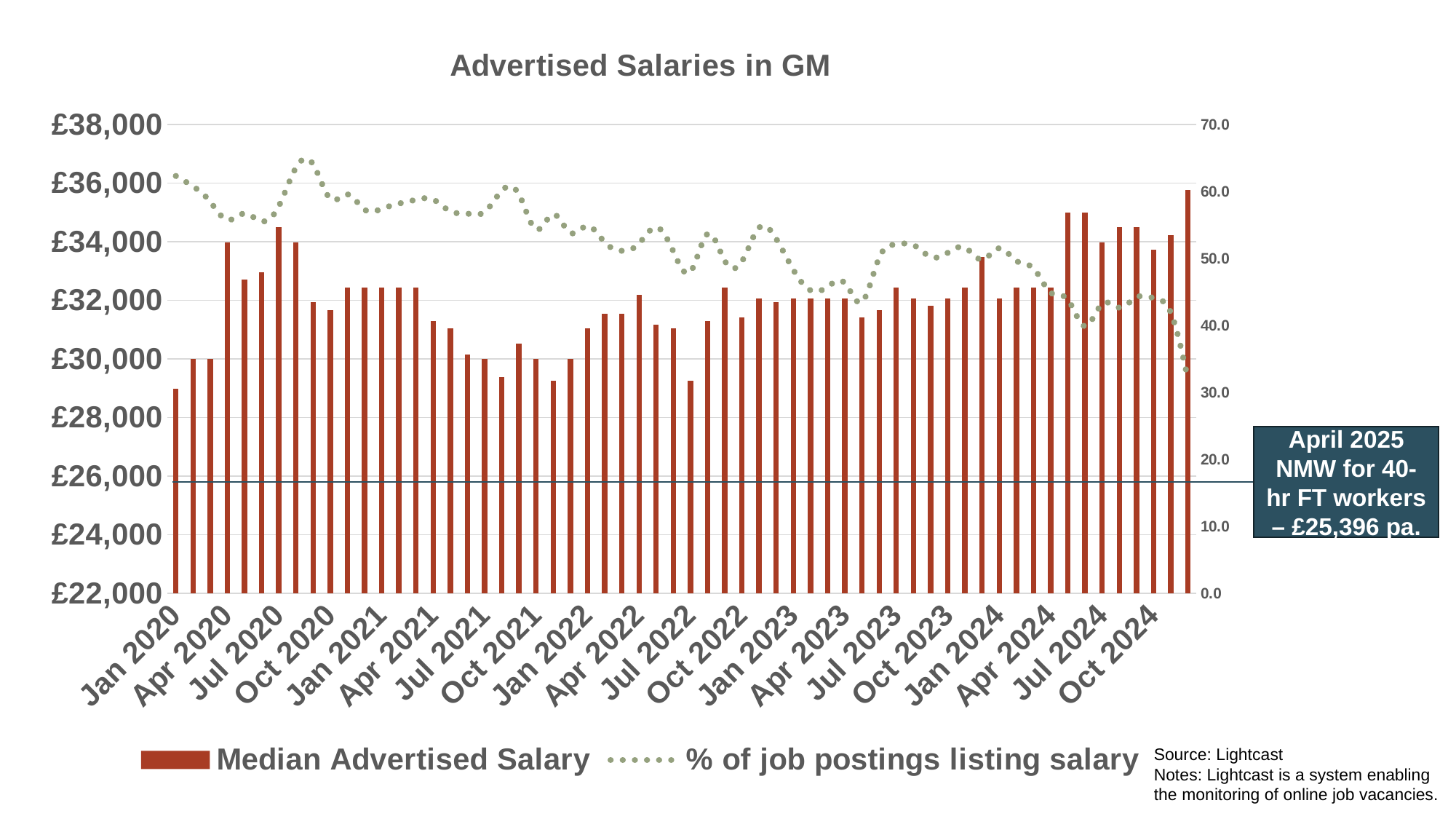
Is the Median Advertised Salary for Jan 2020 greater or less than £30,000? less How many series does the legend list? 2 Which month has the highest Median Advertised Salary bar? Dec 2024 Is the Median Advertised Salary for Jul 2020 greater or less than £32,000? greater Is the % of job postings listing salary for Jan 2020 greater or less than 50.0? greater Does the % of job postings listing salary line generally rise or fall from Jan 2020 to the end of 2024? fall What is the title of the chart? Advertised Salaries in GM How many quarterly date labels are shown on the x axis? 20 What kind of chart is shown on the slide? A combined bar and line chart Which is larger, the Median Advertised Salary for Jan 2020 or for Jul 2020? Jul 2020 According to the annotation box, what is the April 2025 NMW for 40-hr FT workers? £25,396 pa.